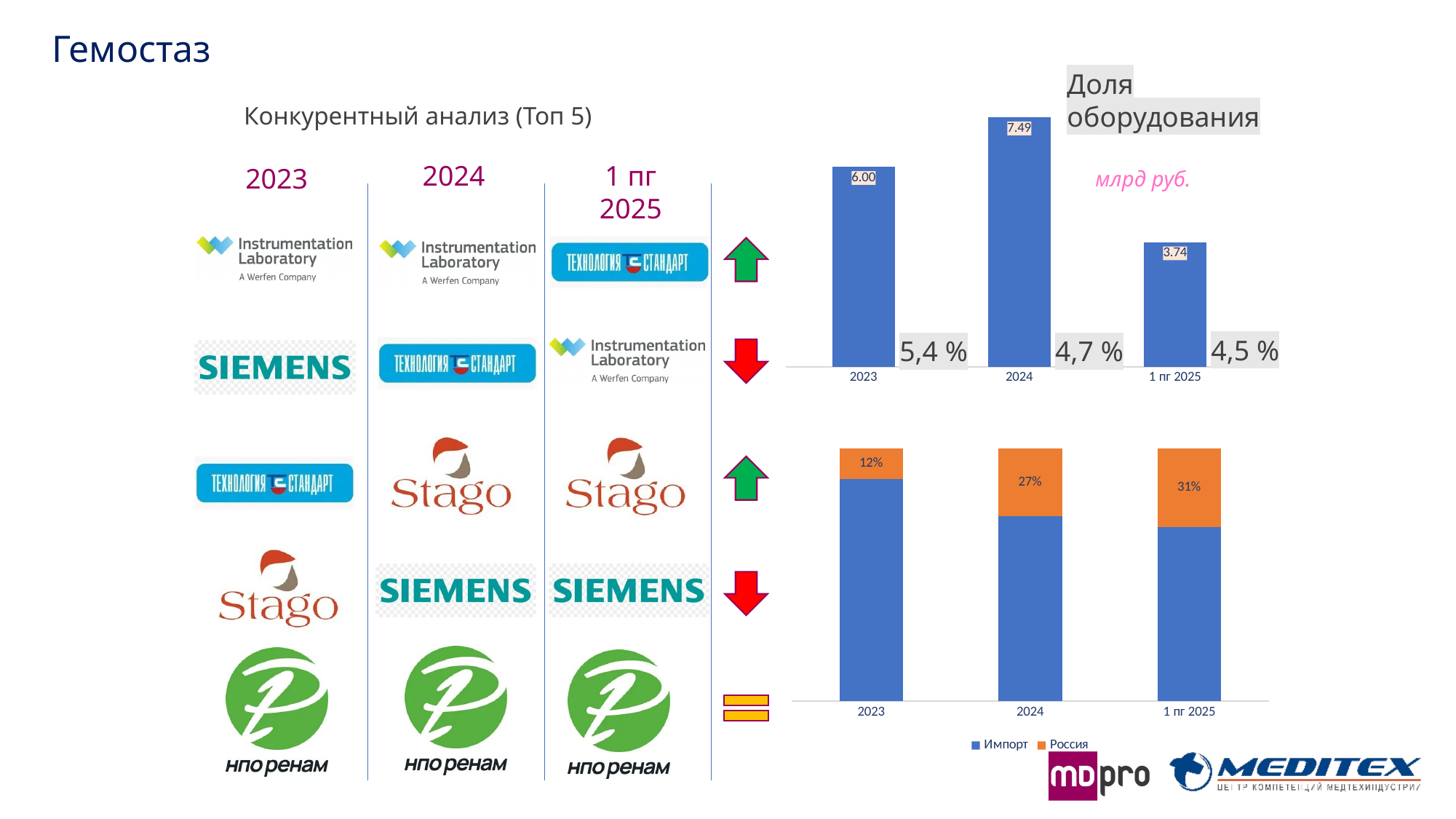
In the top bar chart, which period has the highest value? 2024 In the bottom stacked bar chart, does the Россия share rise or fall from 2023 to 1 пг 2025? rise In the top bar chart, which is larger: the value for 2023 or the value for 1 пг 2025? 2023 In the top bar chart, what is the value for 2024? 7.49 How many periods are shown on the x axis of the top bar chart? 3 In the top bar chart, what is the value for 1 пг 2025? 3.74 How many series does the legend of the bottom stacked bar chart list? 2 In the bottom stacked bar chart, what is the Россия share for 2024? 27% In the top bar chart, which period has the lowest value? 1 пг 2025 In the top bar chart, what is the difference between the 2024 value and the 2023 value? 1.49 In the bottom stacked bar chart, what is the Россия share for 1 пг 2025? 31% What kind of chart is the top chart on the slide? bar chart